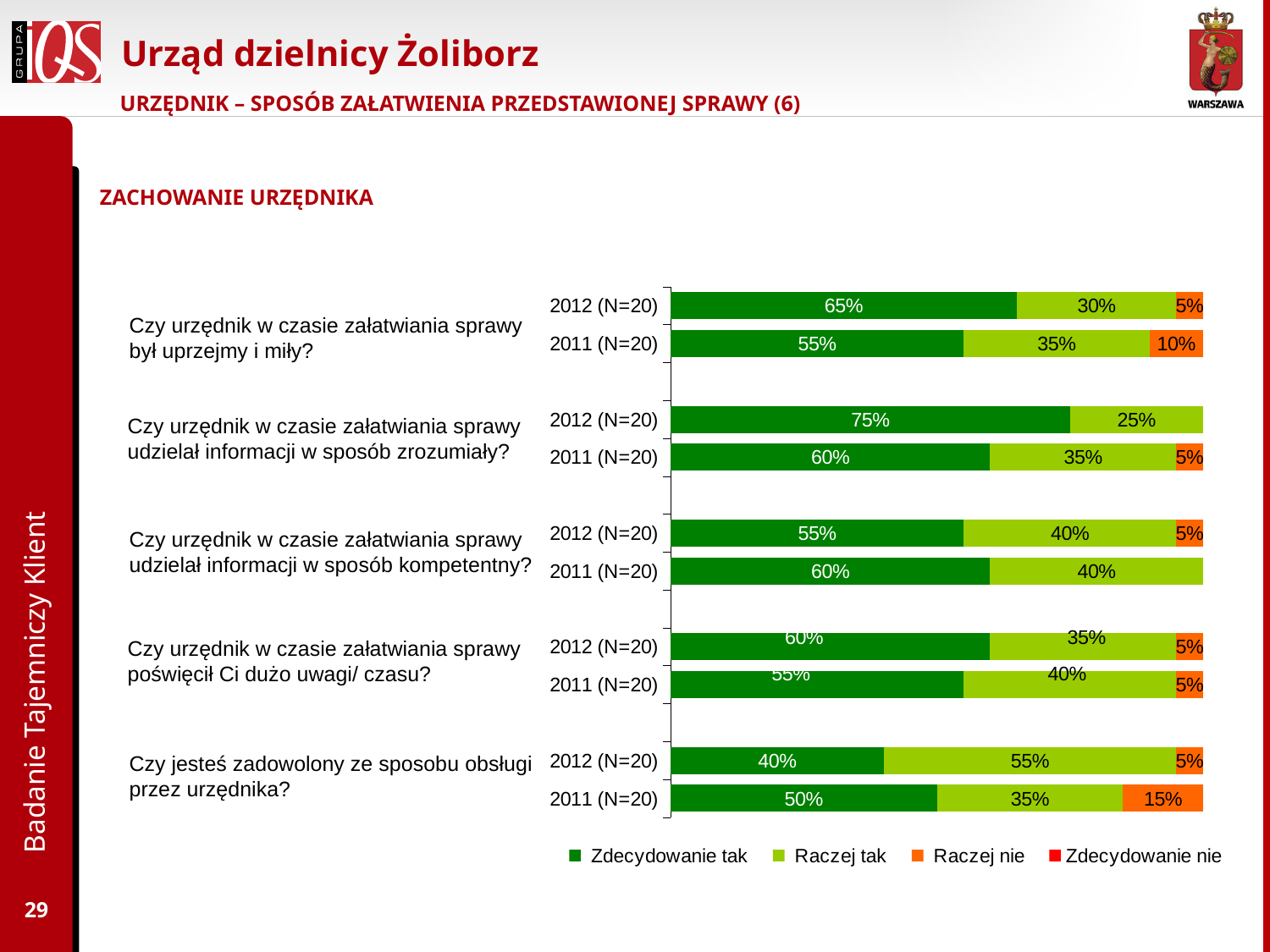
How many series does the legend list? 4 What percentage answered "Zdecydowanie tak" in 2011 to "Czy urzędnik w czasie załatwiania sprawy udzielał informacji w sposób kompetentny?"? 60% What is the total of the 2012 (N=20) bar for "Czy urzędnik w czasie załatwiania sprawy był uprzejmy i miły?"? 100% Which bar has the highest "Zdecydowanie tak" share? 2012 (N=20) for "Czy urzędnik w czasie załatwiania sprawy udzielał informacji w sposób zrozumiały?" (75%) What percentage answered "Raczej nie" in 2011 to "Czy jesteś zadowolony ze sposobu obsługi przez urzędnika?"? 15% What percentage answered "Zdecydowanie tak" in 2012 to "Czy urzędnik w czasie załatwiania sprawy był uprzejmy i miły?"? 65% What kind of chart is shown on the slide? Stacked horizontal bar chart How many bars are plotted in the chart? 10 For "Czy jesteś zadowolony ze sposobu obsługi przez urzędnika?", which year has the larger "Raczej tak" share, 2012 or 2011? 2012 (55%) What percentage answered "Raczej tak" in 2012 to "Czy urzędnik w czasie załatwiania sprawy udzielał informacji w sposób zrozumiały?"? 25% Which bar has the lowest "Zdecydowanie tak" share? 2012 (N=20) for "Czy jesteś zadowolony ze sposobu obsługi przez urzędnika?" (40%) By how many percentage points did the "Zdecydowanie tak" share for "Czy urzędnik w czasie załatwiania sprawy był uprzejmy i miły?" change from 2011 to 2012? 10 percentage points (55% to 65%)